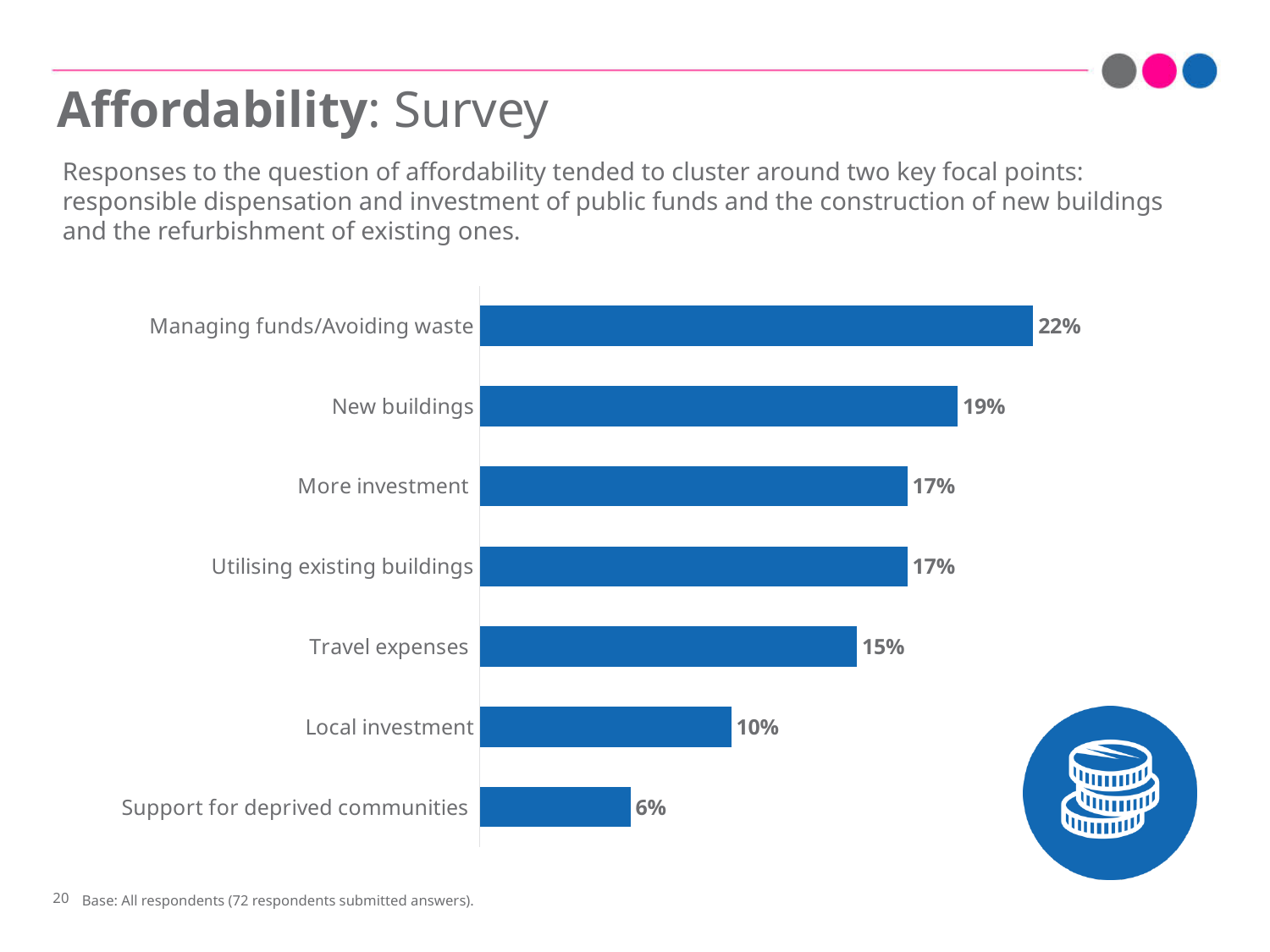
What kind of chart is shown on the slide? Bar chart What is the value for Support for deprived communities? 6% Which two categories share the same value of 17%? More investment and Utilising existing buildings Which is larger, the value for Travel expenses or the value for Local investment? Travel expenses What is the value for New buildings? 19% How many categories are shown in the chart? 7 What is the value for Travel expenses? 15% What is the difference between the values for Local investment and Support for deprived communities? 4% What is the value for Managing funds/Avoiding waste? 22% Which category has the highest value? Managing funds/Avoiding waste What is the difference between the values for Managing funds/Avoiding waste and New buildings? 3% Which category has the lowest value? Support for deprived communities